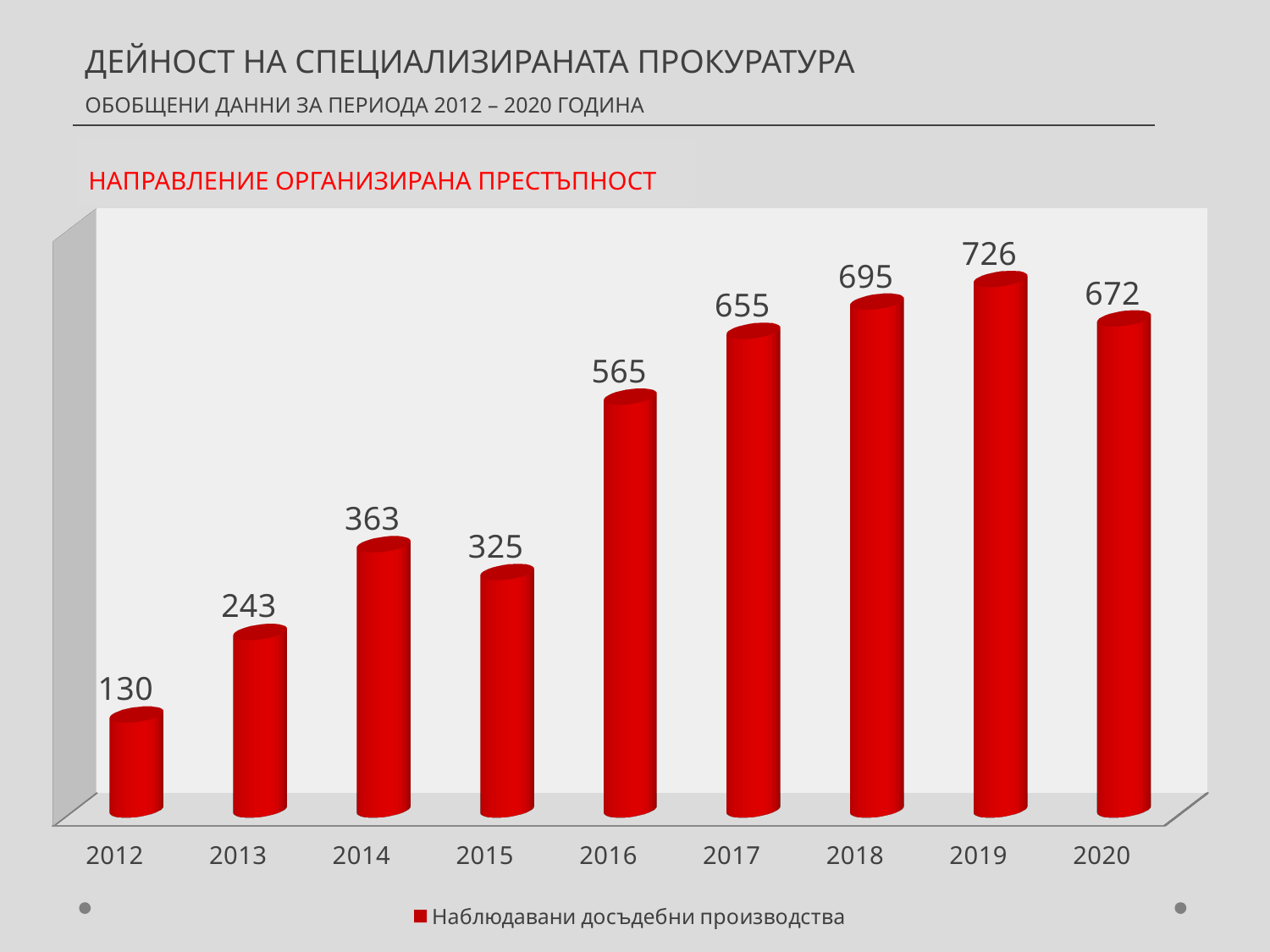
How many series does the legend list? 1 What is the legend entry for the series? Наблюдавани досъдебни производства How many years are shown on the x axis? 9 What is the value for 2016? 565 Which year has the lowest value? 2012 Which is larger, the value for 2017 or the value for 2020? 2017 What kind of chart is shown on the slide? Bar chart What is the difference between the values for 2019 and 2018? 31 What is the difference between the values for 2014 and 2015? 38 Which year has the highest value? 2019 What is the value for 2012? 130 What is the value for 2020? 672